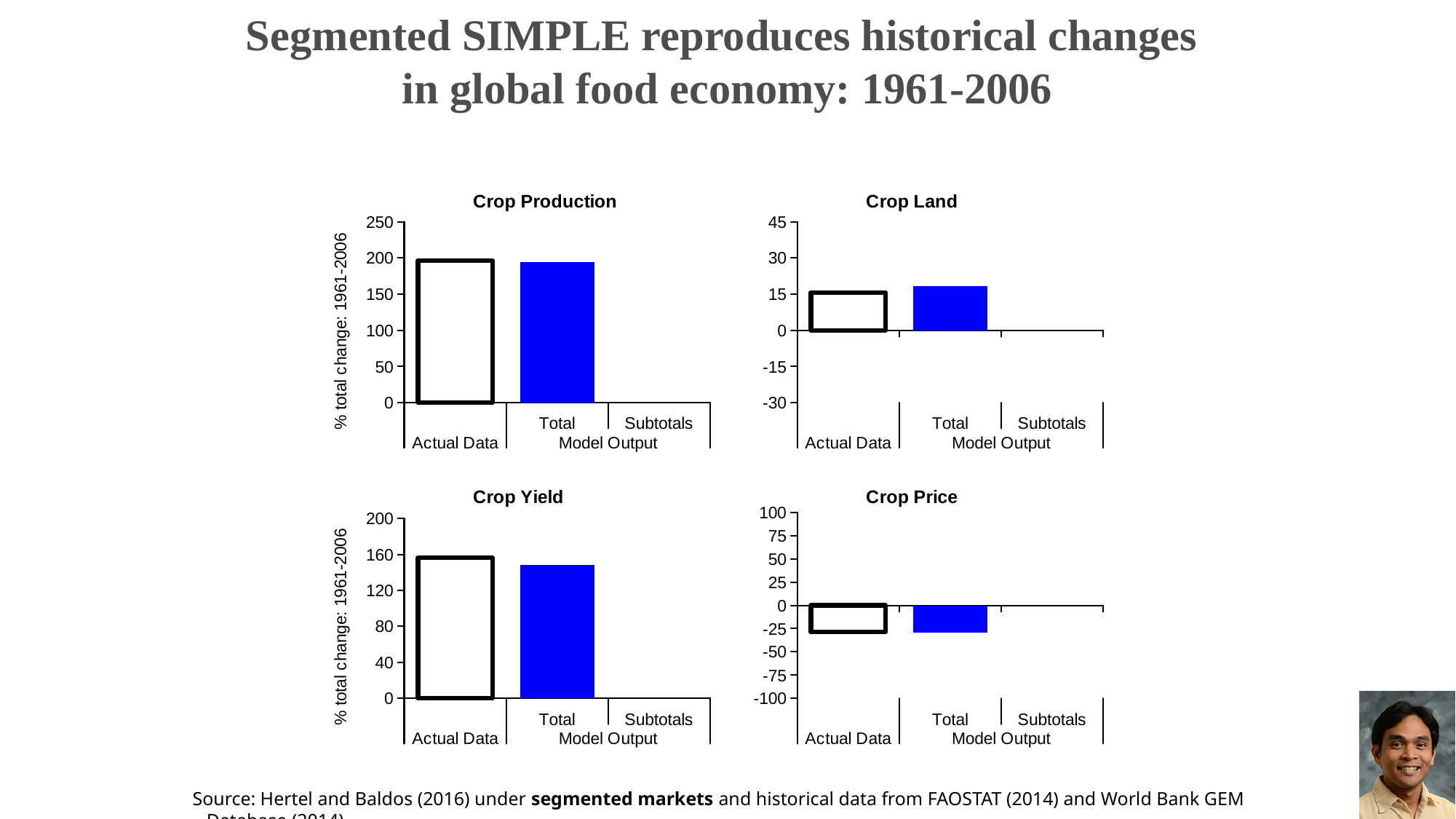
In the Crop Price chart, is the value for Total (Model Output) greater or less than -50? greater In the Crop Production chart, is the value for Total (Model Output) greater or less than 100? greater In the Crop Yield chart, is the value for Total (Model Output) greater or less than 160? less What is the y-axis label of the Crop Yield chart? % total change: 1961-2006 In the Crop Yield chart, which is larger, the value for Actual Data or the value for Total (Model Output)? Actual Data How many bars are plotted in the Crop Production chart? 2 What kind of chart is the Crop Production chart? bar chart